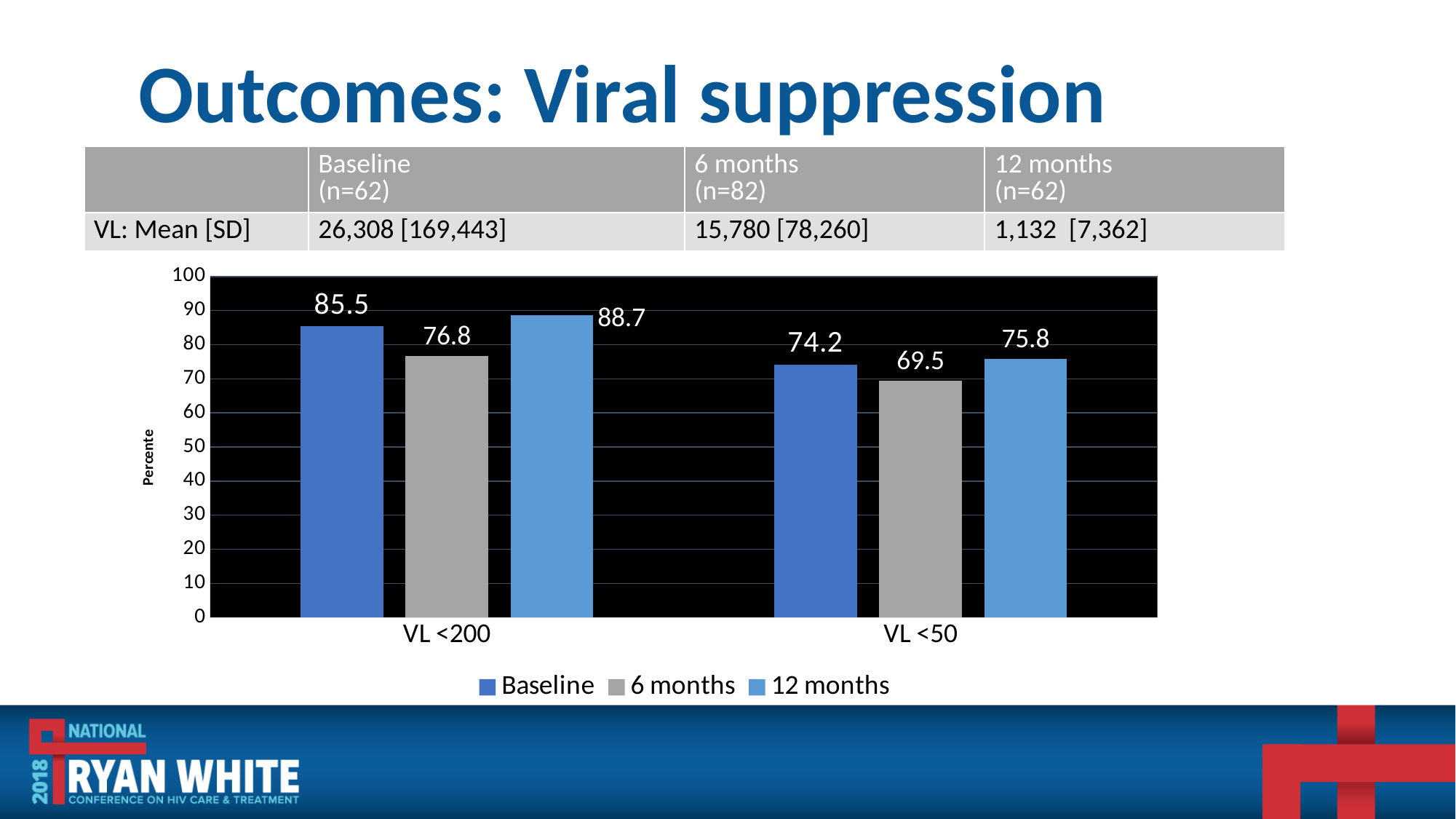
What kind of chart is shown on the slide? bar chart What is the difference between the Baseline and 6 months values for VL <50? 4.7 Is the 6 months value for VL <50 greater or less than 70? less What is the 6 months value for VL <50? 69.5 Which series has the highest value for VL <50? 12 months What is the difference between the 12 months and Baseline values for VL <200? 3.2 Which series has the lowest value for VL <200? 6 months Which is larger: the Baseline value for VL <200 or the Baseline value for VL <50? VL <200 What is the 12 months value for VL <200? 88.7 How many series does the legend list? 3 What is the label of the y axis? Percente What is the Baseline value for VL <200? 85.5